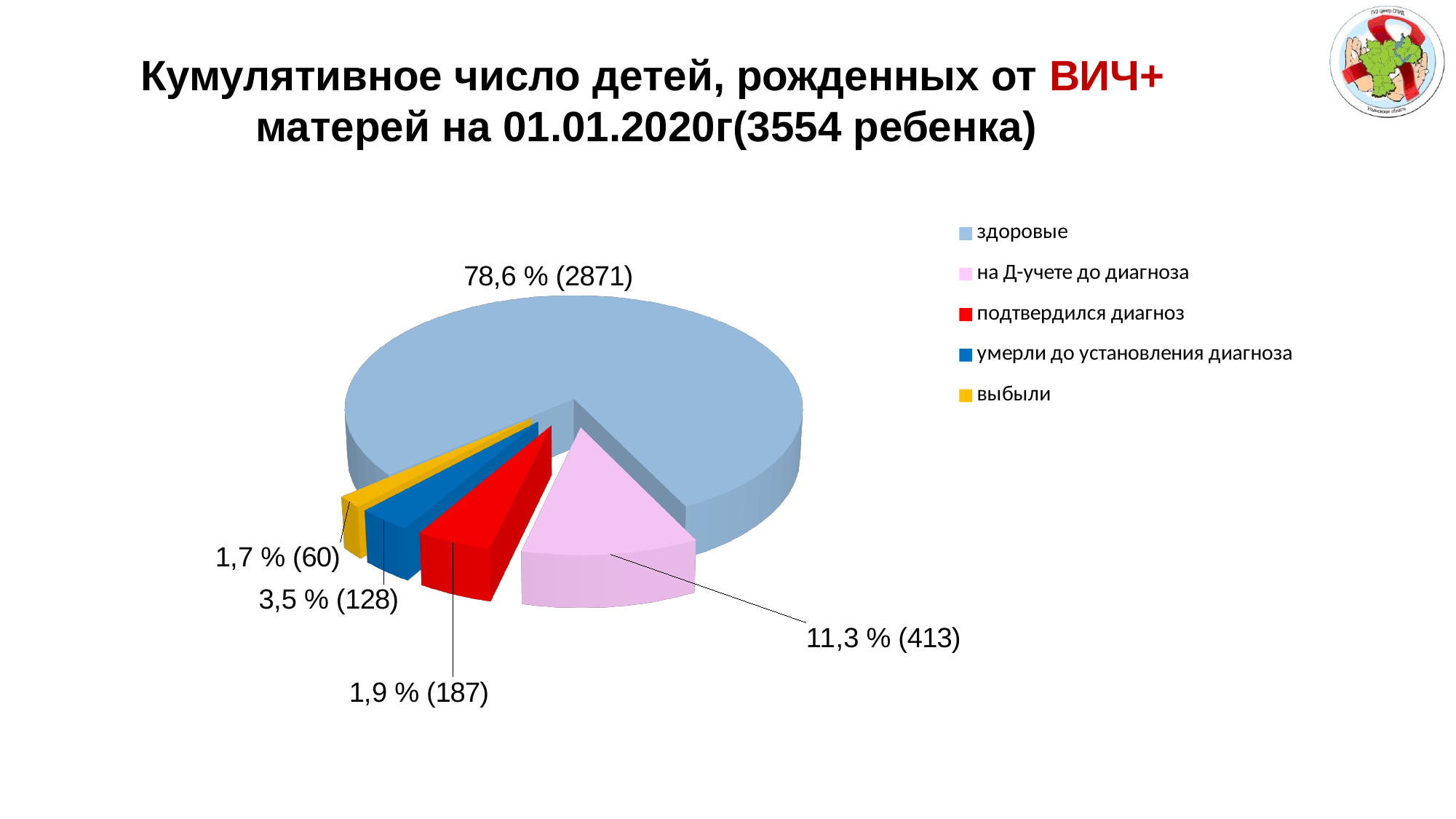
What percentage and count are shown for the "здоровые" slice? 78,6 % (2871) What is the difference in the number of children between "здоровые" and "на Д-учете до диагноза"? 2458 Which category has the smallest slice of the pie? выбыли How many entries does the legend list? 5 Which is larger, the count for "умерли до установления диагноза" or the count for "выбыли"? умерли до установления диагноза How many slices does the pie chart have? 5 What percentage and count are shown for the "подтвердился диагноз" slice? 1,9 % (187) What kind of chart is shown on the slide? pie chart What percentage and count are shown for the "на Д-учете до диагноза" slice? 11,3 % (413) What colour is the "подтвердился диагноз" slice? red Which category has the largest slice of the pie? здоровые What percentage and count are shown for the "выбыли" slice? 1,7 % (60)